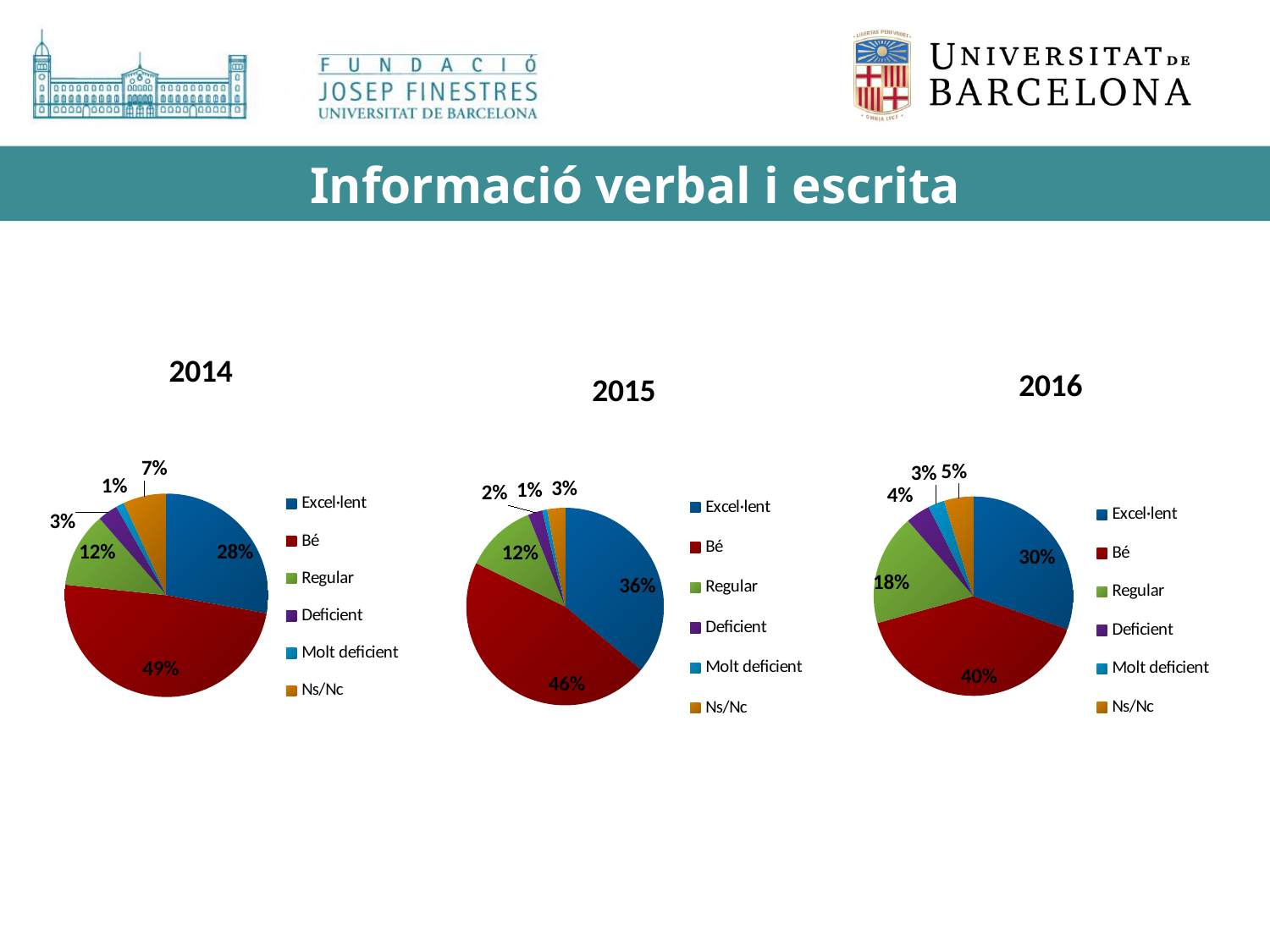
In the 2015 pie chart, what is the value for Excel·lent? 36% In the 2014 pie chart, what is the value for Ns/Nc? 7% In the 2014 pie chart, what share does Bé have? 49% In the 2015 pie chart, what is the difference between Regular and Ns/Nc? 9% In the 2016 pie chart, what is the value for Regular? 18% In the 2016 pie chart, which is larger, Excel·lent or Regular? Excel·lent In the 2015 pie chart, which category has the smallest slice? Molt deficient What type of chart is used for the 2015 data? Pie chart How many pie charts are shown on the slide? 3 How many categories does the legend of the 2014 pie chart list? 6 In the 2014 pie chart, what is the difference between the Bé and Excel·lent shares? 21% In the 2016 pie chart, which category has the largest slice? Bé